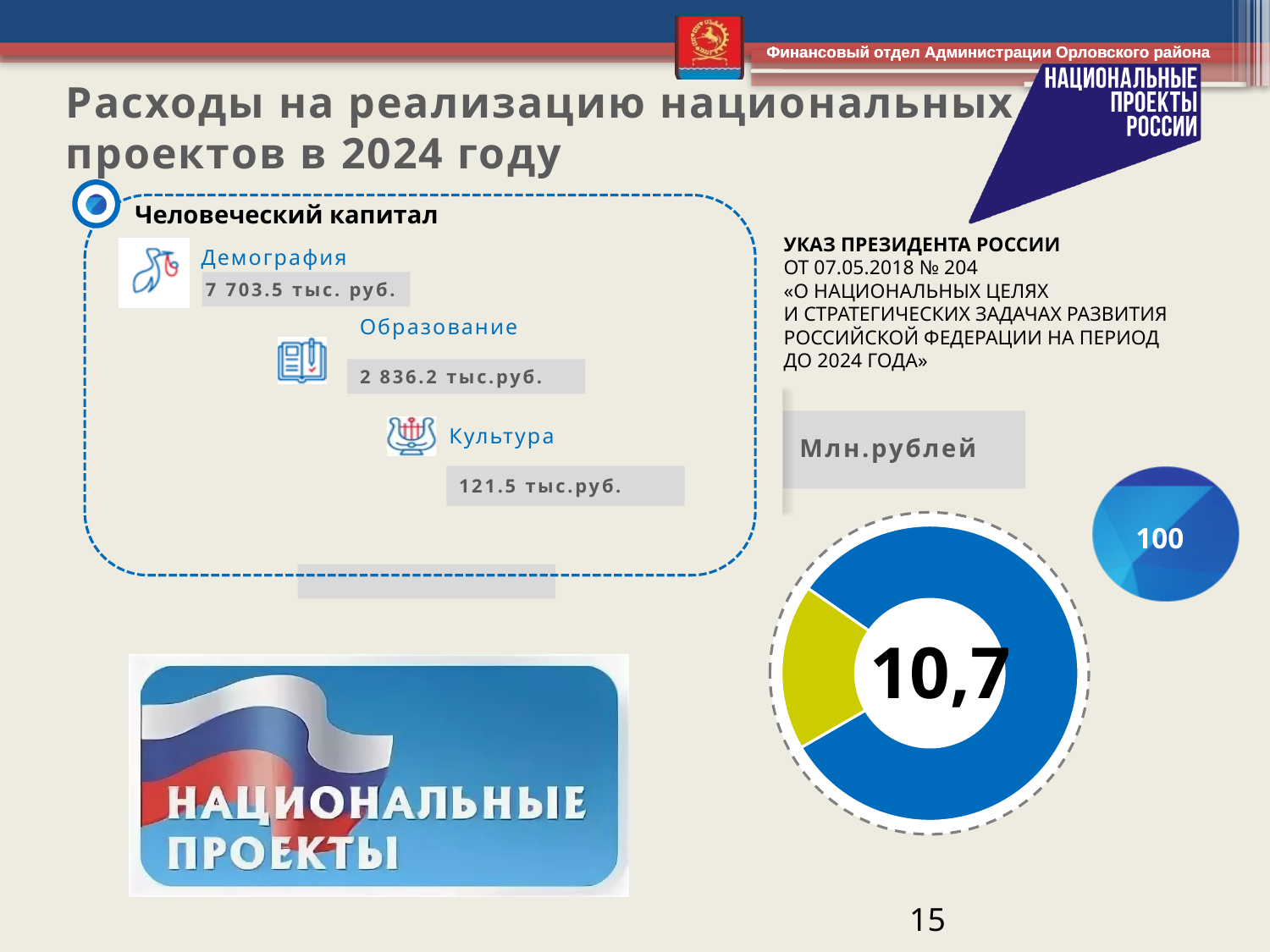
Which colour slice is the largest in the doughnut chart? blue What number is printed in the centre of the doughnut chart? 10,7 What unit label is shown in the grey box above the doughnut chart? Млн.рублей How many slices does the doughnut chart on the right have? 2 Which colour slice is the smallest in the doughnut chart? yellow In the doughnut chart, which slice is larger, the blue one or the yellow one? blue What kind of chart is shown on the right side of the slide? doughnut chart